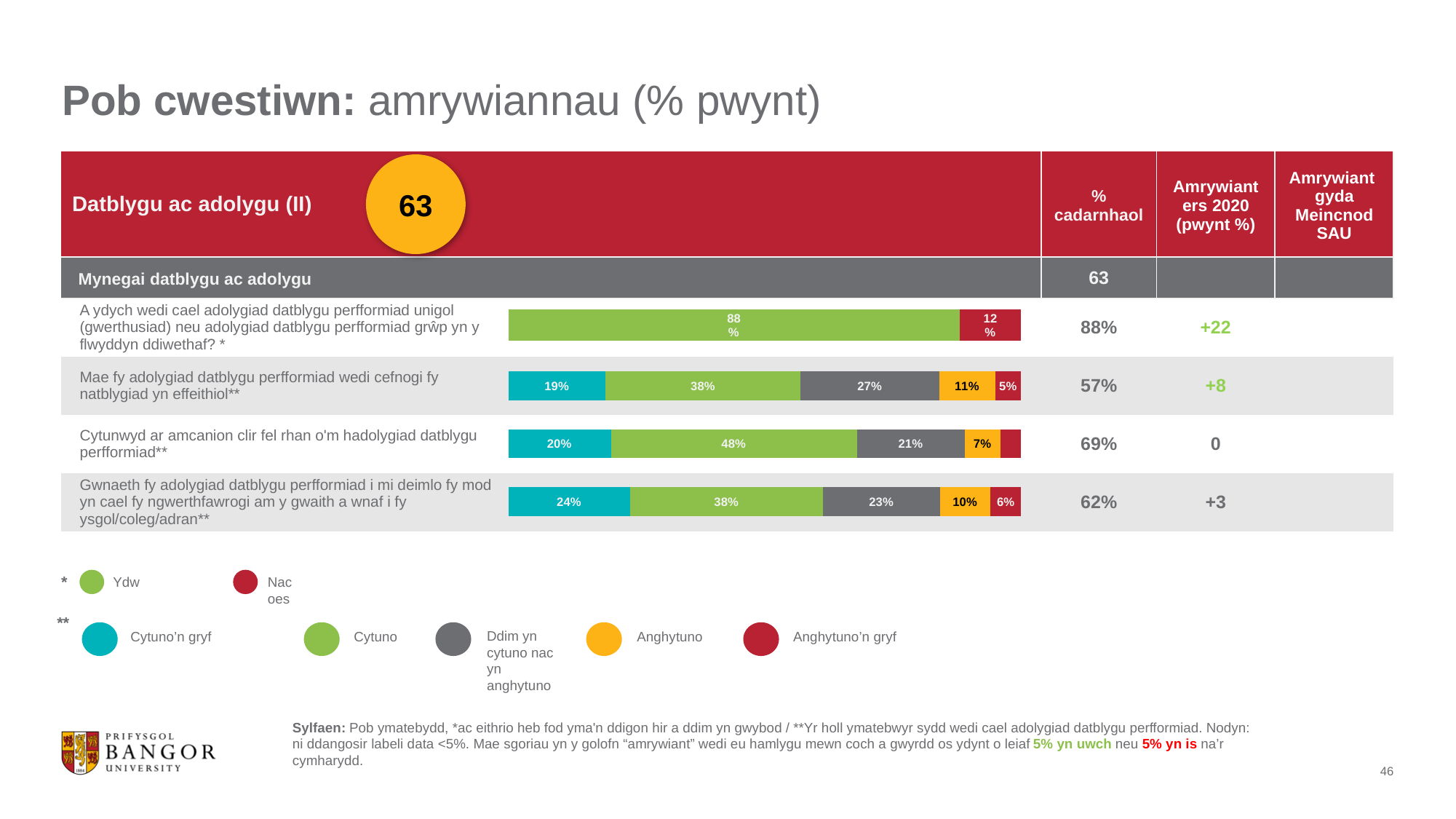
How many question rows have a stacked bar on this slide? 4 What is the Amrywiant ers 2020 (pwynt %) value for "A ydych wedi cael adolygiad datblygu perfformiad unigol..."? +22 What type of chart is used to show the response breakdown for each question? Stacked bar chart In the bar for "A ydych wedi cael adolygiad datblygu perfformiad unigol...", what percentage answered Nac oes? 12% In the bar for "Mae fy adolygiad datblygu perfformiad wedi cefnogi fy natblygiad yn effeithiol", which is larger: the Cytuno segment or the Ddim yn cytuno nac yn anghytuno segment? Cytuno Which of the four questions has the highest % cadarnhaol value? A ydych wedi cael adolygiad datblygu perfformiad unigol (gwerthusiad) neu adolygiad datblygu perfformiad grŵp yn y flwyddyn ddiwethaf? In the bar for "Cytunwyd ar amcanion clir fel rhan o'm hadolygiad datblygu perfformiad", what percentage is shown for Cytuno? 48% In the bar for "Mae fy adolygiad datblygu perfformiad wedi cefnogi fy natblygiad yn effeithiol", what percentage is shown for Cytuno'n gryf? 19% In the bar for "Gwnaeth fy adolygiad datblygu perfformiad i mi deimlo fy mod yn cael fy ngwerthfawrogi...", what percentage is shown for Anghytuno'n gryf? 6% What is the difference between the Cytuno'n gryf percentages for "Gwnaeth fy adolygiad datblygu perfformiad i mi deimlo..." (24%) and "Mae fy adolygiad datblygu perfformiad wedi cefnogi..." (19%)? 5 percentage points How many response categories does the ** legend list? 5 Which of the four questions has the lowest % cadarnhaol value? Mae fy adolygiad datblygu perfformiad wedi cefnogi fy natblygiad yn effeithiol